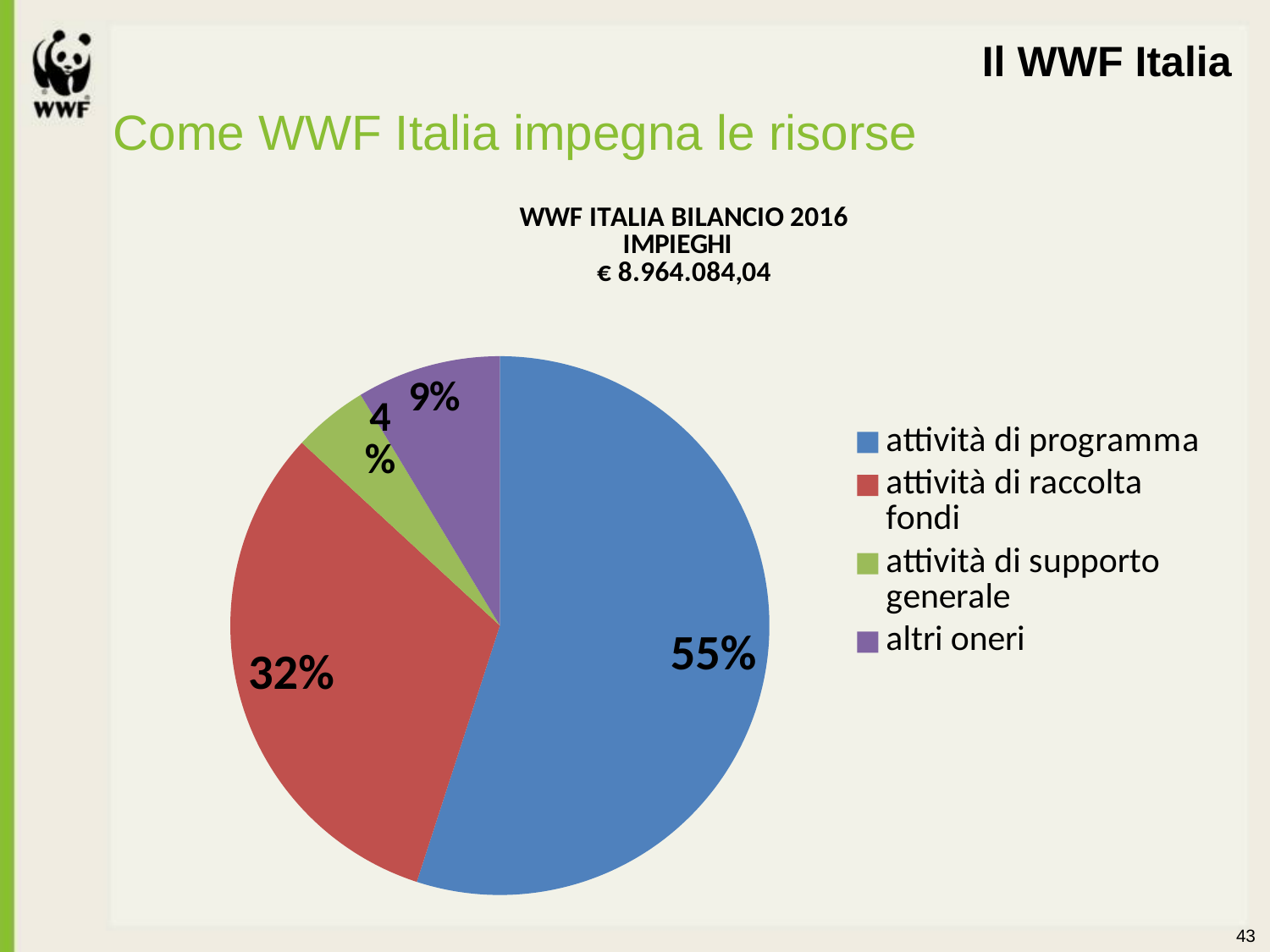
What colour is the slice for 'attività di raccolta fondi'? red Which category has the largest slice of the pie? attività di programma Which is larger, the slice for 'altri oneri' or the slice for 'attività di supporto generale'? altri oneri How many categories does the pie chart show? 4 What share of the pie does 'attività di supporto generale' represent? 4% What share of the pie does 'attività di programma' represent? 55% What kind of chart is shown on the slide? pie chart Which category has the smallest slice of the pie? attività di supporto generale What total amount in euros is stated in the chart title? € 8.964.084,04 What share of the pie does 'altri oneri' represent? 9% What is the difference in percentage points between 'attività di programma' and 'attività di raccolta fondi'? 23